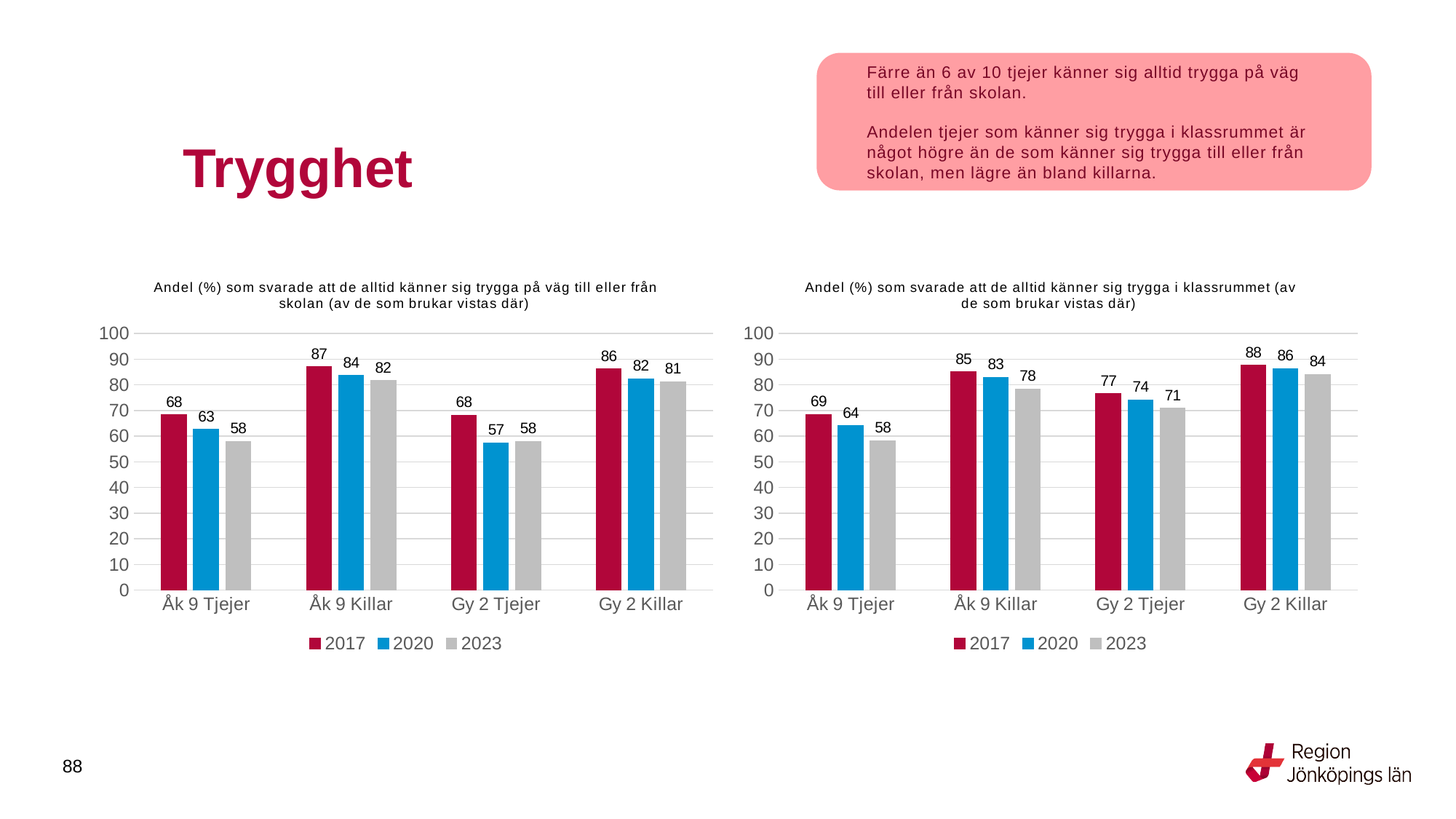
In the right chart (trygga i klassrummet), do the values for Gy 2 Tjejer rise or fall from 2017 to 2023? Fall How many categories are shown on the x axis of the left chart (trygga på väg till eller från skolan)? 4 In the right chart (trygga i klassrummet), which is larger: the 2020 value for Åk 9 Killar or the 2020 value for Gy 2 Killar? Gy 2 Killar In the left chart (trygga på väg till eller från skolan), is the 2020 value for Gy 2 Tjejer greater or less than 60? less In the right chart (trygga i klassrummet), which category has the lowest value for 2023? Åk 9 Tjejer In the right chart (trygga i klassrummet), what is the difference between Gy 2 Killar and Gy 2 Tjejer in 2017? 11 How many series does the legend of the right chart (trygga i klassrummet) list? 3 In the left chart (trygga på väg till eller från skolan), what is the difference between the 2017 and 2023 values for Åk 9 Tjejer? 10 In the left chart (trygga på väg till eller från skolan), what is the value for Åk 9 Tjejer in 2023? 58 What kind of chart is the left chart (trygga på väg till eller från skolan)? Bar chart In the left chart (trygga på väg till eller från skolan), which category has the highest value for 2017? Åk 9 Killar In the right chart (trygga i klassrummet), what is the value for Gy 2 Tjejer in 2020? 74